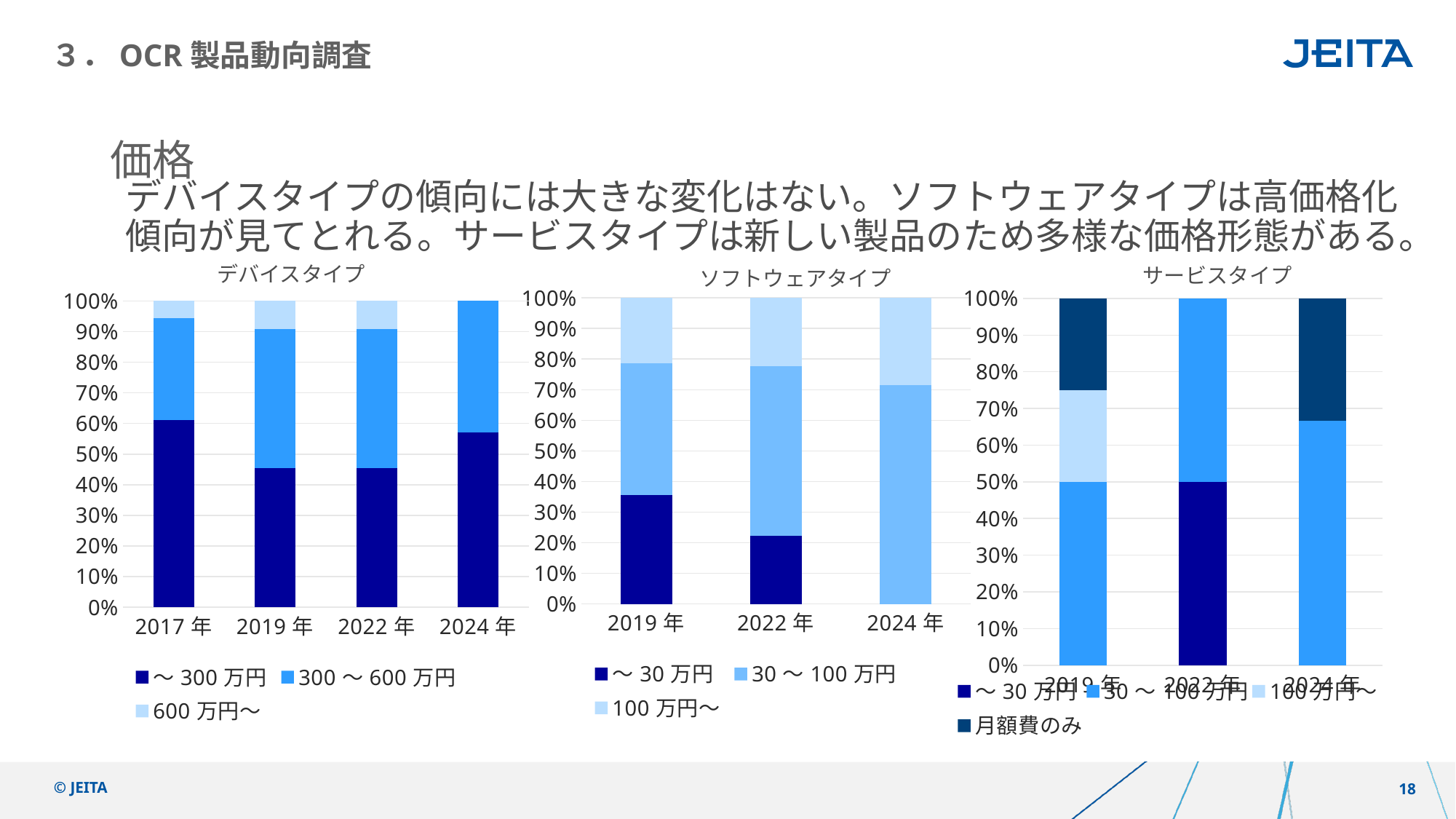
In the ソフトウェアタイプ chart, does the share of ～30万円 rise or fall from 2019年 to 2024年? fall In the デバイスタイプ chart, is the share of ～300万円 in 2017年 greater or less than 50%? greater In the サービスタイプ chart, is the share of 30～100万円 in 2024年 greater or less than 60%? greater In the デバイスタイプ chart, how many years are shown on the x axis? 4 What kind of chart is the デバイスタイプ chart? stacked bar chart In the デバイスタイプ chart, which year has the larger share of ～300万円, 2017年 or 2019年? 2017年 How many series does the legend of the デバイスタイプ chart list? 3 What is the total height of each stacked bar in the ソフトウェアタイプ chart? 100% In the ソフトウェアタイプ chart, is the share of ～30万円 in 2022年 greater or less than 30%? less How many series does the legend of the サービスタイプ chart list? 4 In the ソフトウェアタイプ chart, how many years are shown on the x axis? 3 Which legend entry appears only in the サービスタイプ chart and not in the other two charts? 月額費のみ